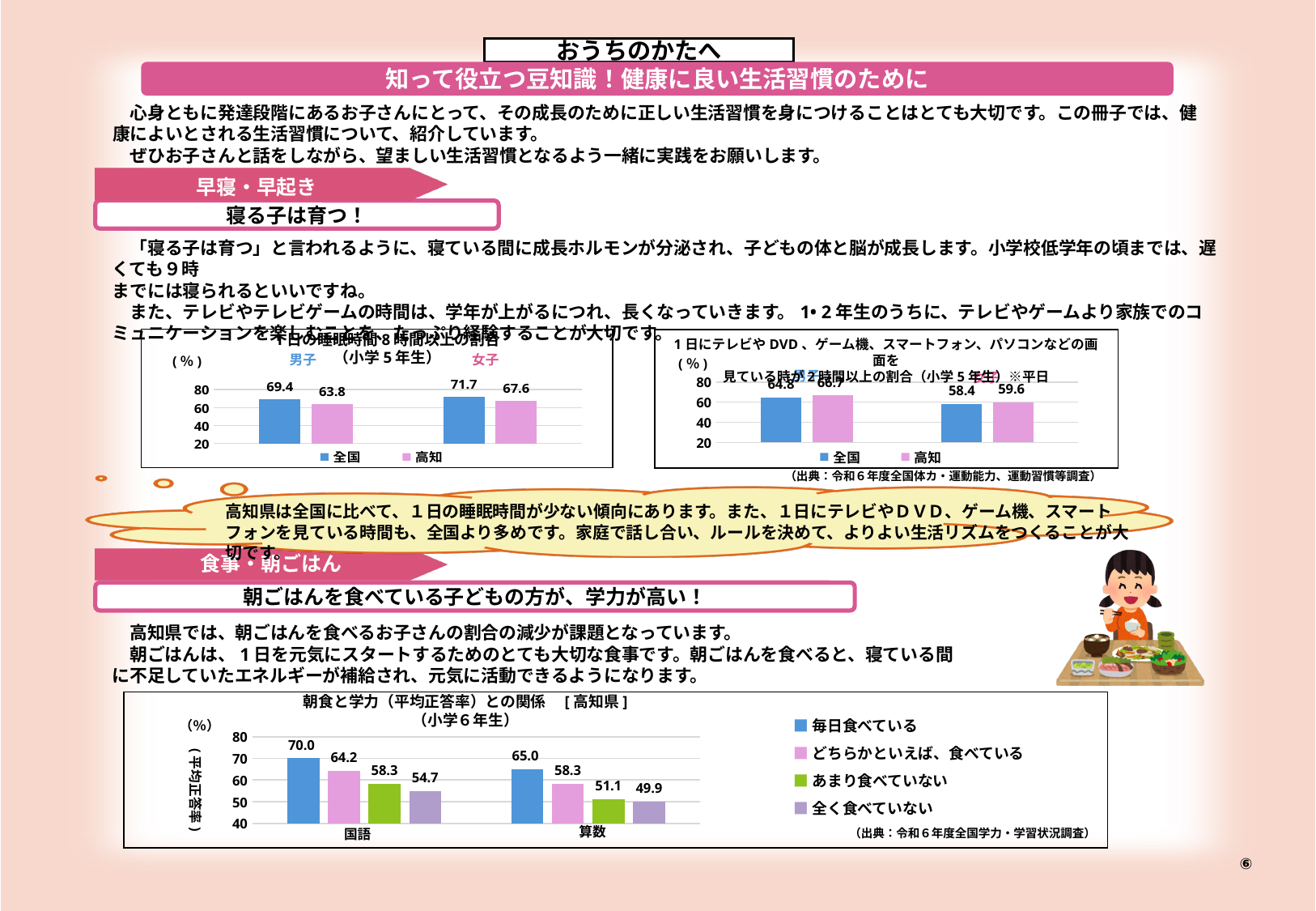
In the bottom chart (朝食と学力との関係), what is the difference between the 国語 values for 毎日食べている and 全く食べていない? 15.3 In the bottom chart (朝食と学力との関係), what is the 算数 value for 全く食べていない? 49.9 What kind of chart is the bottom chart (朝食と学力との関係)? Bar chart In the bottom chart (朝食と学力との関係), how many series does the legend list? 4 In the top-left chart (1日の睡眠時間8時間以上の割合), what is the 高知 value for 男子? 63.8 In the bottom chart (朝食と学力との関係), what is the 国語 value for 毎日食べている? 70.0 In the top-left chart (1日の睡眠時間8時間以上の割合), what is the difference between 全国 and 高知 for 男子? 5.6 In the top-left chart (1日の睡眠時間8時間以上の割合), which is larger for 女子, 全国 or 高知? 全国 In the top-right chart (画面を見ている時間が2時間以上の割合), which is larger for 女子, 全国 or 高知? 高知 In the top-right chart (画面を見ている時間が2時間以上の割合), what is the 高知 value for 男子? 66.7 In the bottom chart (朝食と学力との関係), do the values fall from 毎日食べている to 全く食べていない within 国語? Yes, they fall In the bottom chart (朝食と学力との関係), which breakfast group has the highest 算数 value? 毎日食べている